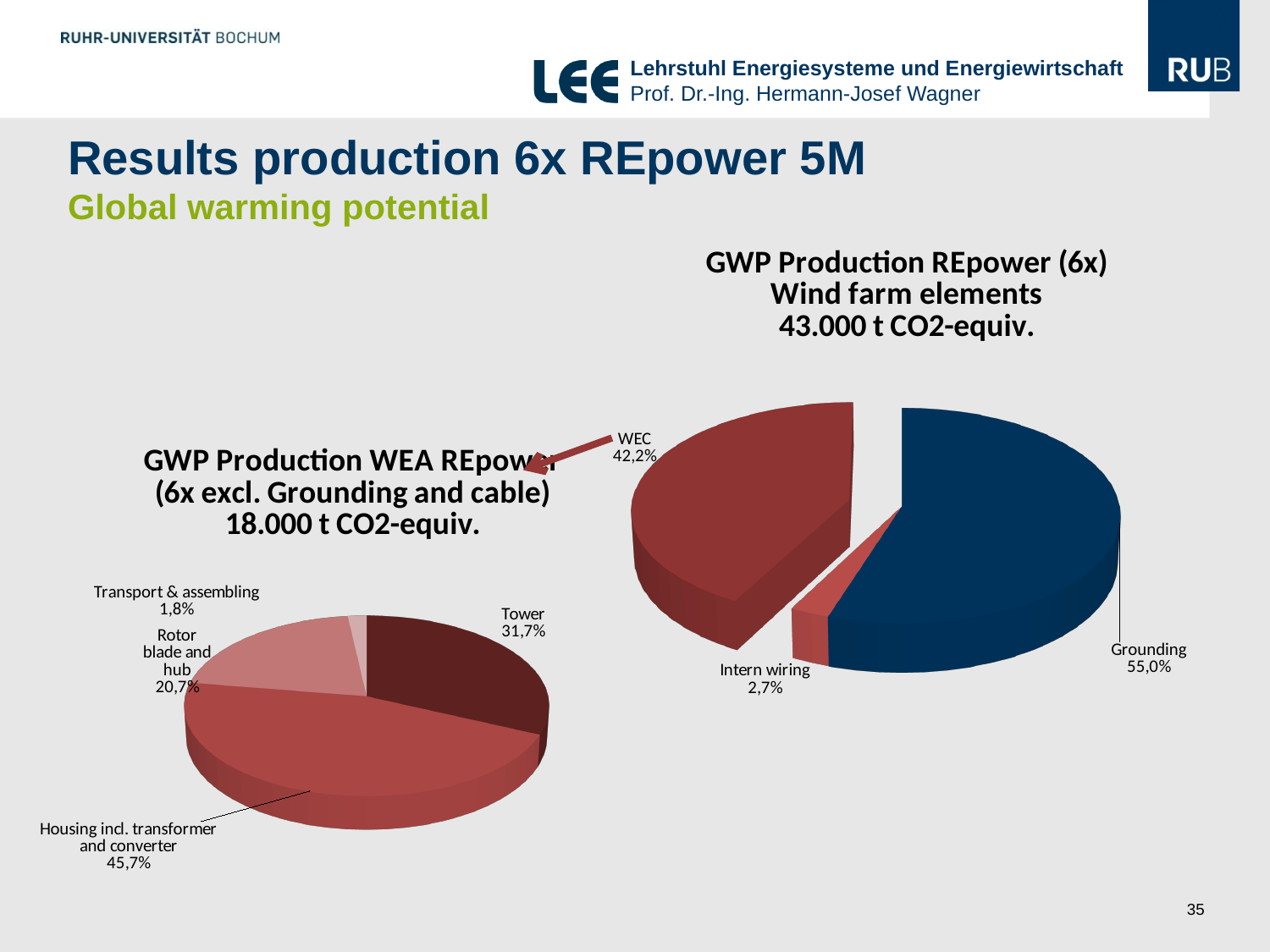
In the 'GWP Production WEA REpower (6x excl. Grounding and cable)' pie chart, what share does Tower have? 31,7% In the 'GWP Production REpower (6x) Wind farm elements' pie chart, which slice is the largest? Grounding In the 'GWP Production REpower (6x) Wind farm elements' pie chart, which slice is the smallest? Intern wiring In the 'GWP Production REpower (6x) Wind farm elements' pie chart, what share does WEC have? 42,2% In the 'GWP Production WEA REpower (6x excl. Grounding and cable)' pie chart, which slice is the smallest? Transport & assembling In the 'GWP Production REpower (6x) Wind farm elements' pie chart, what share does Intern wiring have? 2,7% In the 'GWP Production WEA REpower (6x excl. Grounding and cable)' pie chart, which is larger: Tower or Rotor blade and hub? Tower What kind of chart is used for 'GWP Production WEA REpower (6x excl. Grounding and cable)'? Pie chart How many slices does the 'GWP Production REpower (6x) Wind farm elements' pie chart have? 3